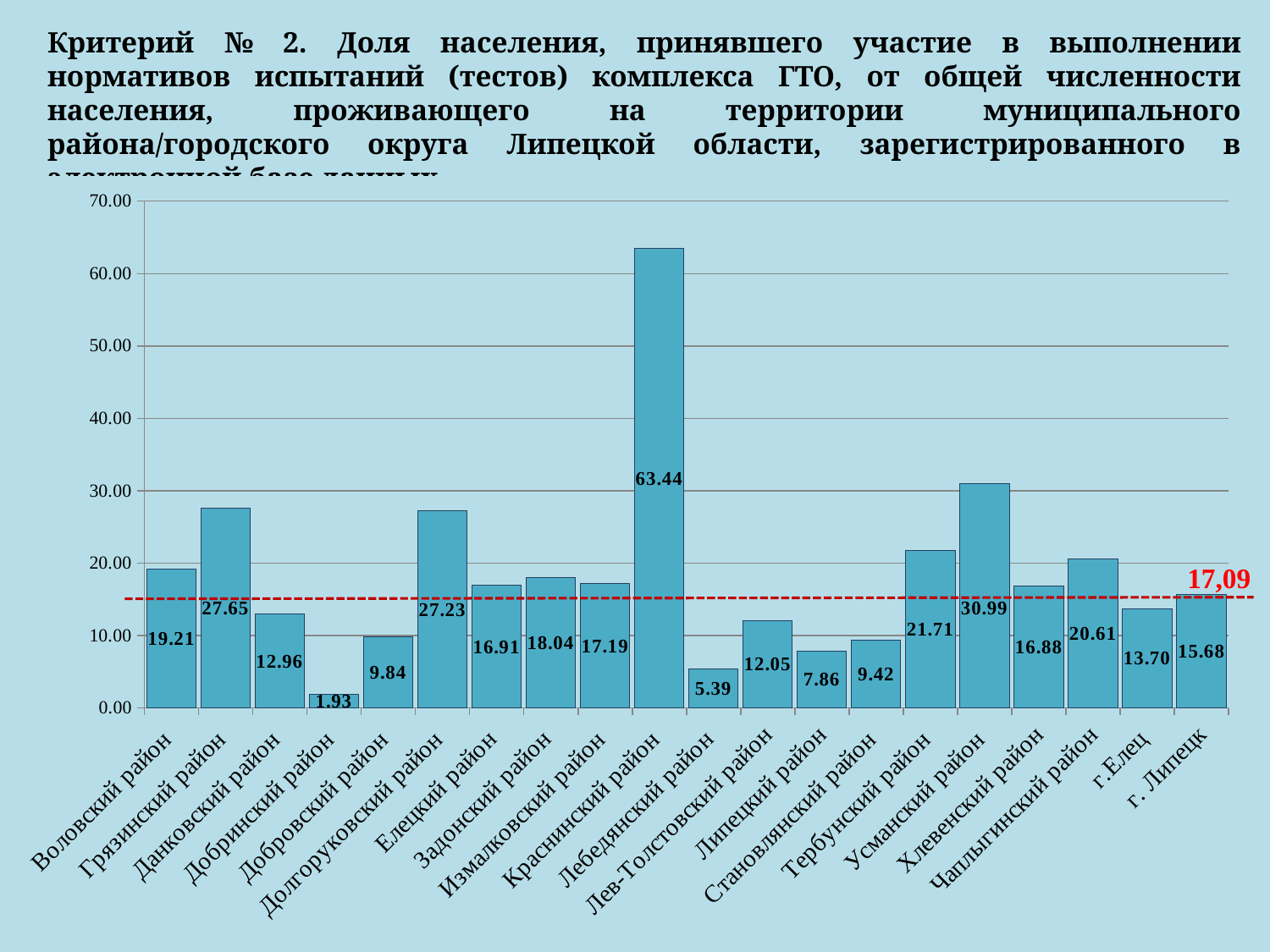
What value is marked by the red dashed horizontal line? 17,09 What value is shown for г. Липецк? 15.68 How many categories are shown on the x axis? 20 Which is larger, the value for Тербунский район or the value for Чаплыгинский район? Тербунский район What value is shown for Усманский район? 30.99 What is the difference between the values for Грязинский район and Долгоруковский район? 0.42 What value is shown for Краснинский район? 63.44 Which category has the lowest value? Добринский район Is the value for Лебедянский район greater or less than 10.00? less What kind of chart is shown on the slide? bar chart Which category has the highest value? Краснинский район What value is shown for Добринский район? 1.93